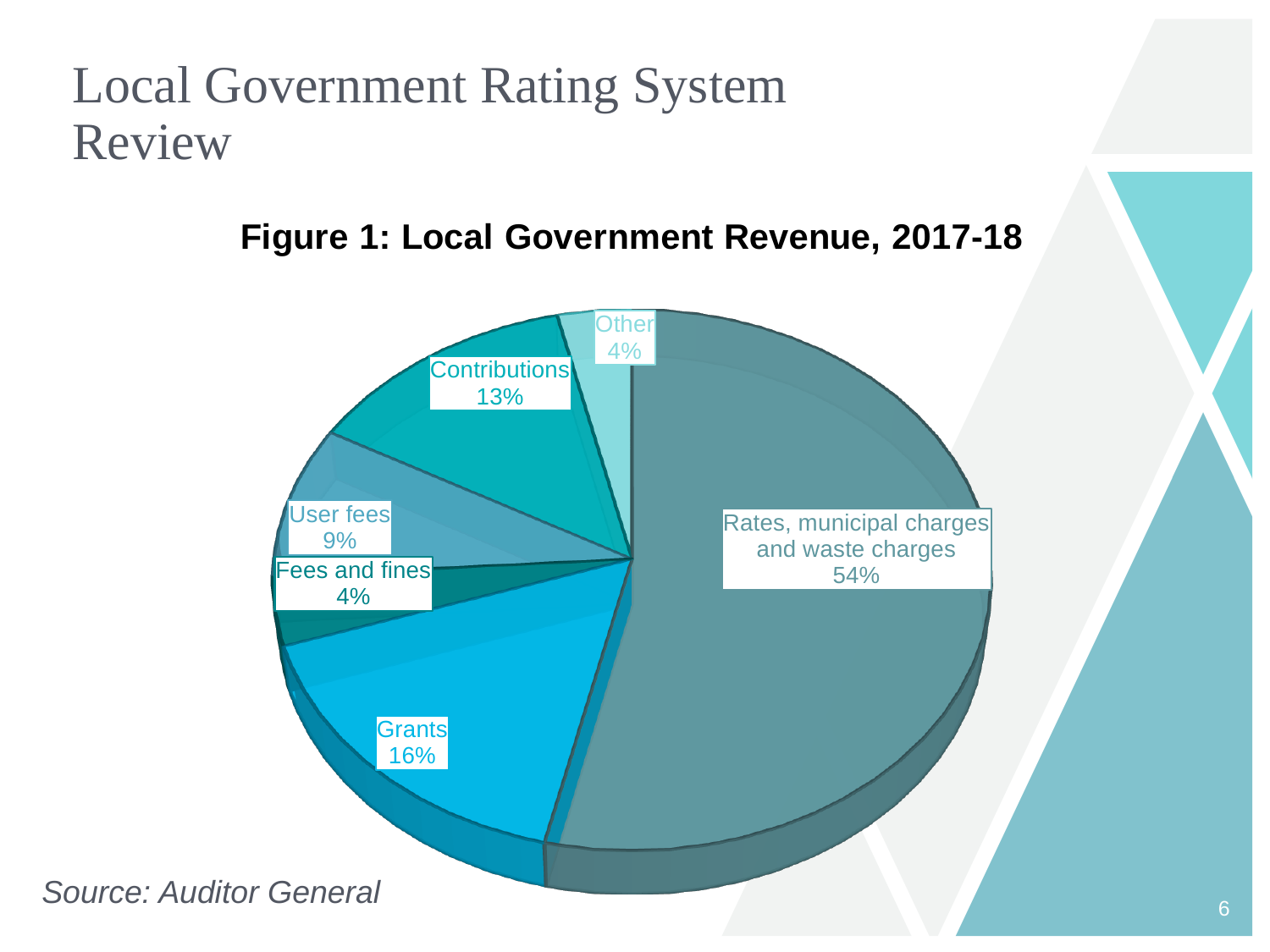
Which is larger, the share for user fees or the share for fees and fines? User fees What is the difference in percentage points between grants and contributions? 3 What percentage of revenue is from grants? 16% How many slices does the pie chart have? 6 What is the title of the chart? Figure 1: Local Government Revenue, 2017-18 What percentage of revenue is from user fees? 9% What percentage of revenue is from contributions? 13% What share of local government revenue comes from rates, municipal charges and waste charges? 54% What type of chart is shown in Figure 1? pie chart Which two categories each account for 4% of revenue? Other and Fees and fines What is the combined share of grants and contributions? 29% Which category has the largest share of local government revenue? Rates, municipal charges and waste charges